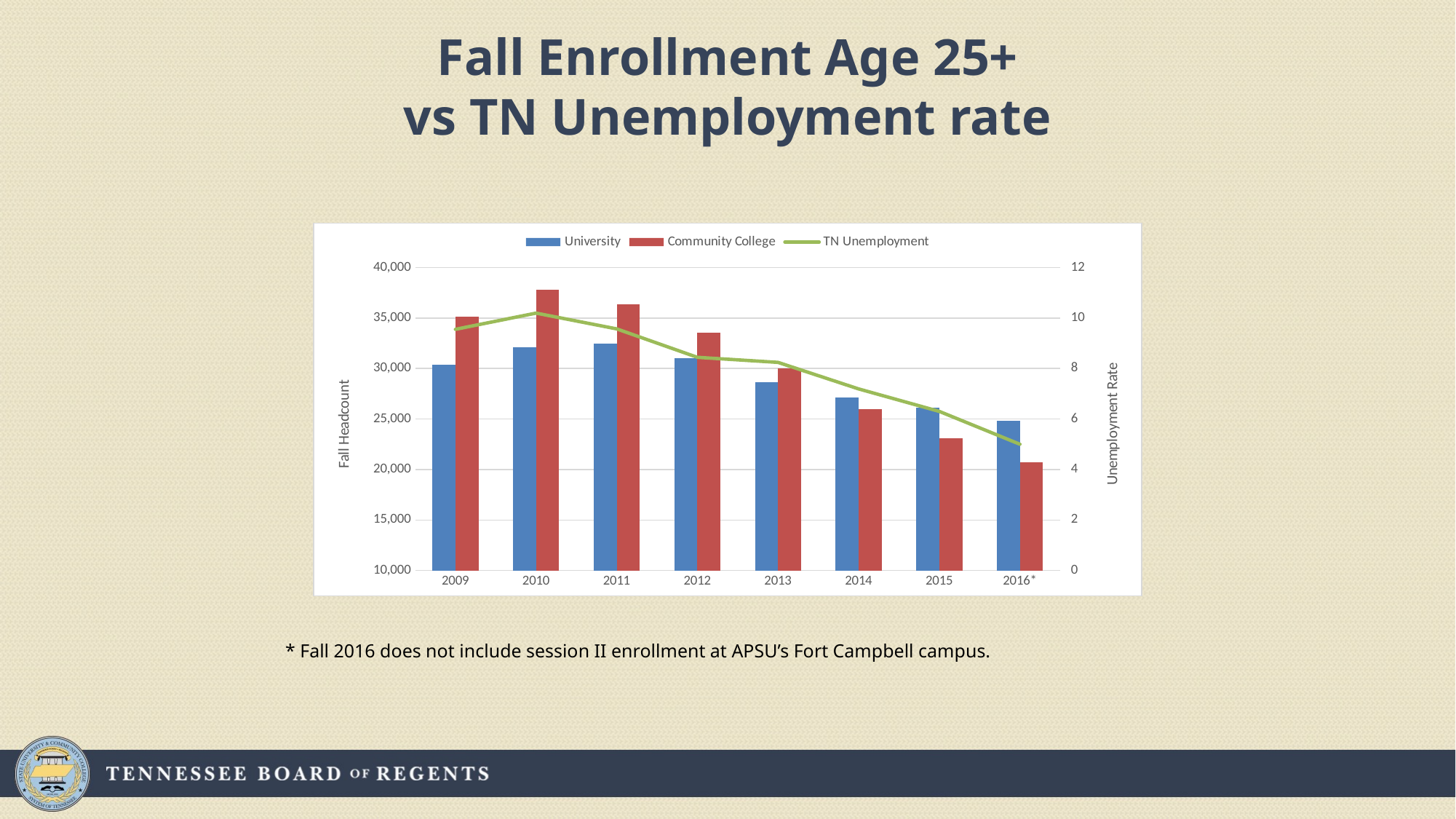
Is the TN Unemployment rate for 2016* greater or less than 6? less In 2015, which is larger, the University headcount or the Community College headcount? University In which year is the University headcount lowest? 2016* In which year is the Community College headcount lowest? 2016* In which year is the Community College headcount highest? 2010 How many years are shown along the x axis? 8 In which year is the TN Unemployment rate highest? 2010 Is the University headcount for 2013 greater or less than 30,000? less How does the TN Unemployment rate change from 2010 to 2016*? It falls What kind of chart is shown on the slide? A bar chart combined with a line How many series does the legend list? 3 Is the Community College headcount for 2010 greater or less than 35,000? greater